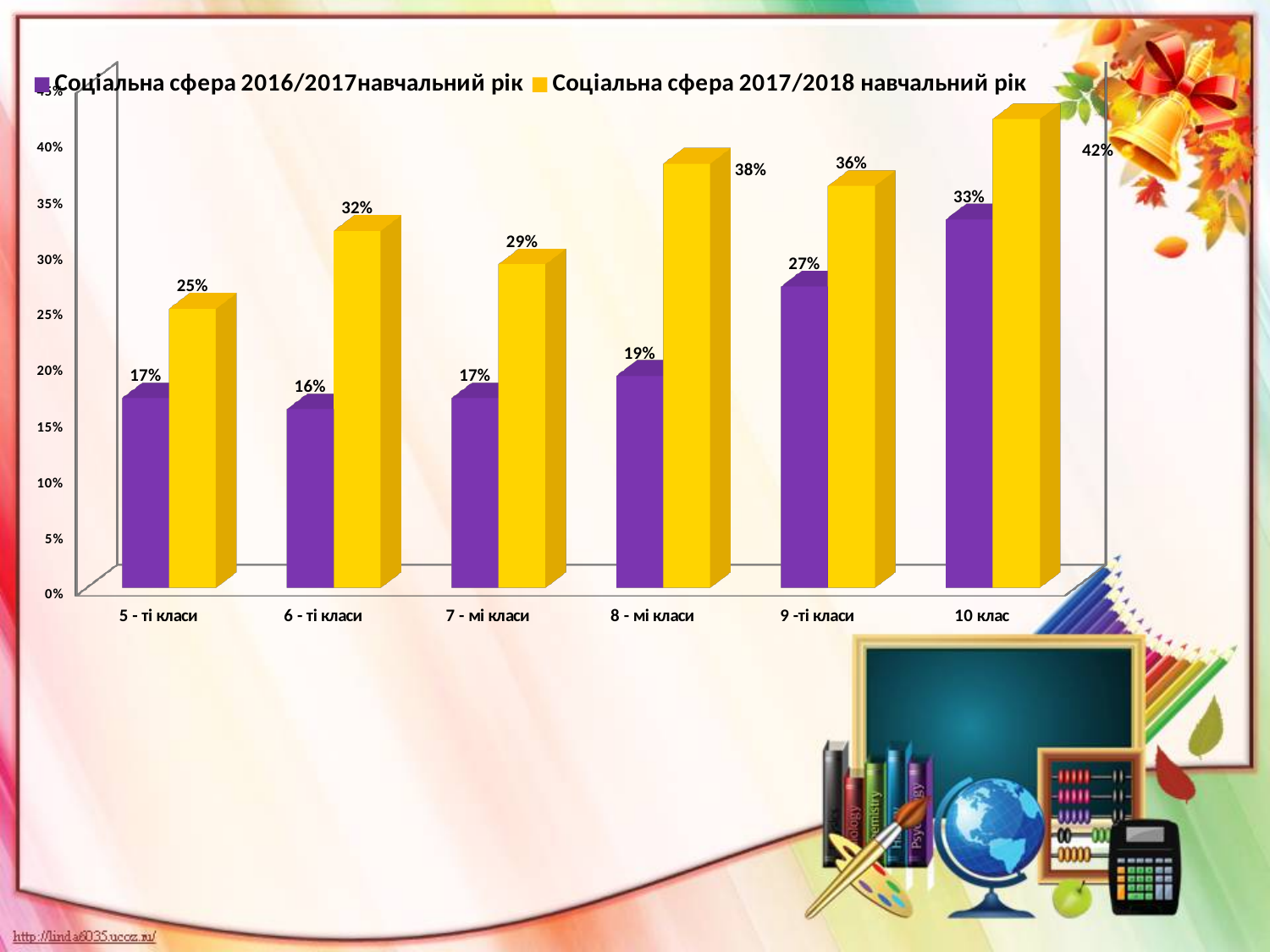
How many series does the legend list? 2 What is the value for 8 - мі класи in the series Соціальна сфера 2017/2018 навчальний рік? 38% What type of chart is shown on the slide? bar chart What is the value for 6 - ті класи in the series Соціальна сфера 2017/2018 навчальний рік? 32% What is the difference between the 2017/2018 and 2016/2017 values for 10 клас? 9% Which is larger for 7 - мі класи: the 2016/2017 value or the 2017/2018 value? 2017/2018 (29%) Which category has the highest value in the series Соціальна сфера 2017/2018 навчальний рік? 10 клас Which category has the lowest value in the series Соціальна сфера 2016/2017 навчальний рік? 6 - ті класи How many class categories are shown on the x axis? 6 What is the value for 9 -ті класи in the series Соціальна сфера 2016/2017 навчальний рік? 27% What colour are the bars for Соціальна сфера 2017/2018 навчальний рік? yellow Does the value for Соціальна сфера 2016/2017 навчальний рік generally rise or fall from 5 - ті класи to 10 клас? rise